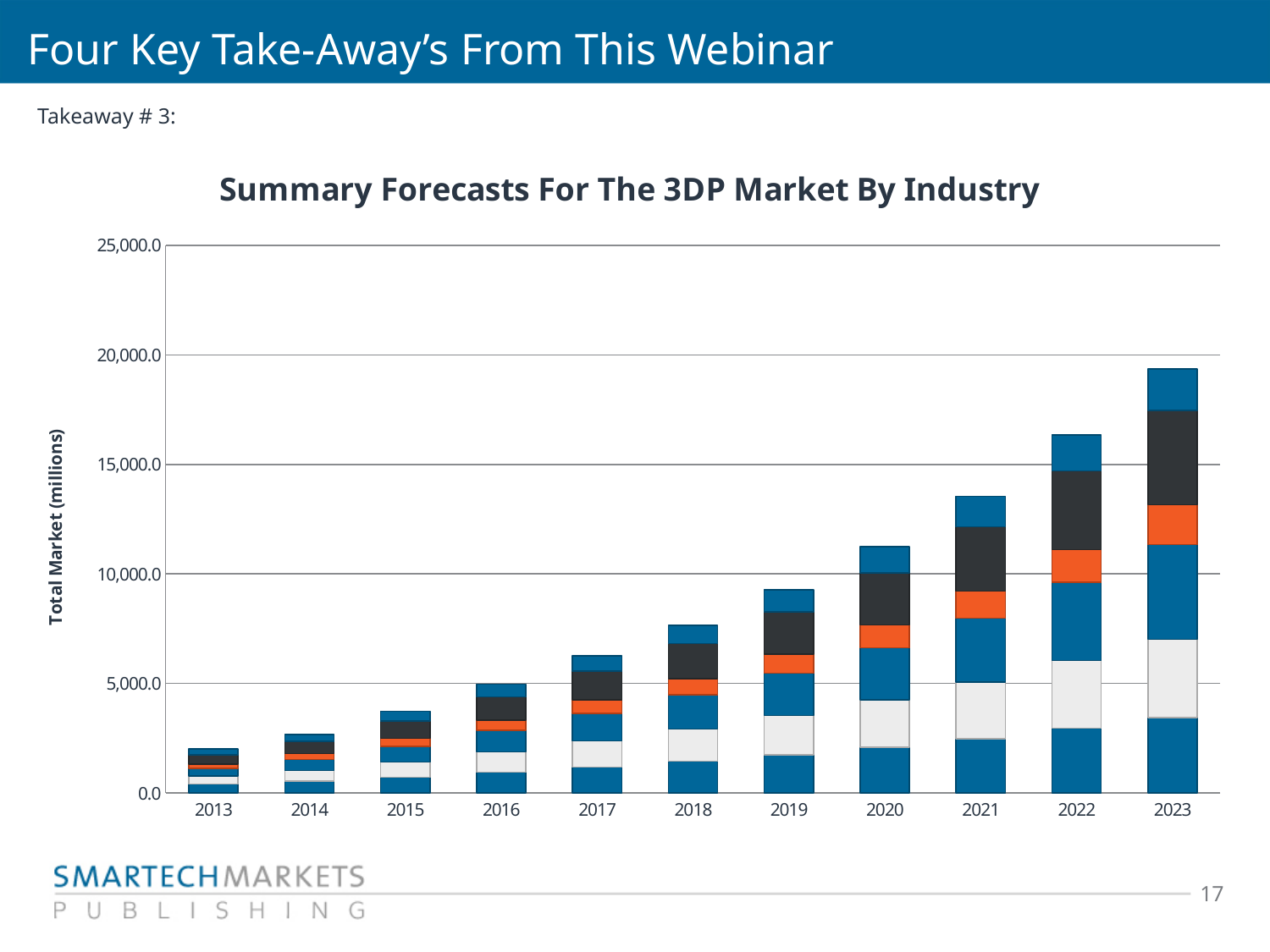
Do the total market values rise or fall from 2013 to 2023? Rise Is the total market value for 2023 greater or less than 20,000.0? less Which year has the lowest total market value in the chart? 2013 Is the total market value for 2018 greater or less than 5,000.0? greater Is the total market value for 2015 greater or less than 5,000.0? less Which year has the highest total market value in the chart? 2023 Which year has a larger total market value, 2020 or 2017? 2020 How many years are shown along the x axis of the chart? 11 What kind of chart is shown on the slide? Stacked bar chart What is the title of the chart? Summary Forecasts For The 3DP Market By Industry